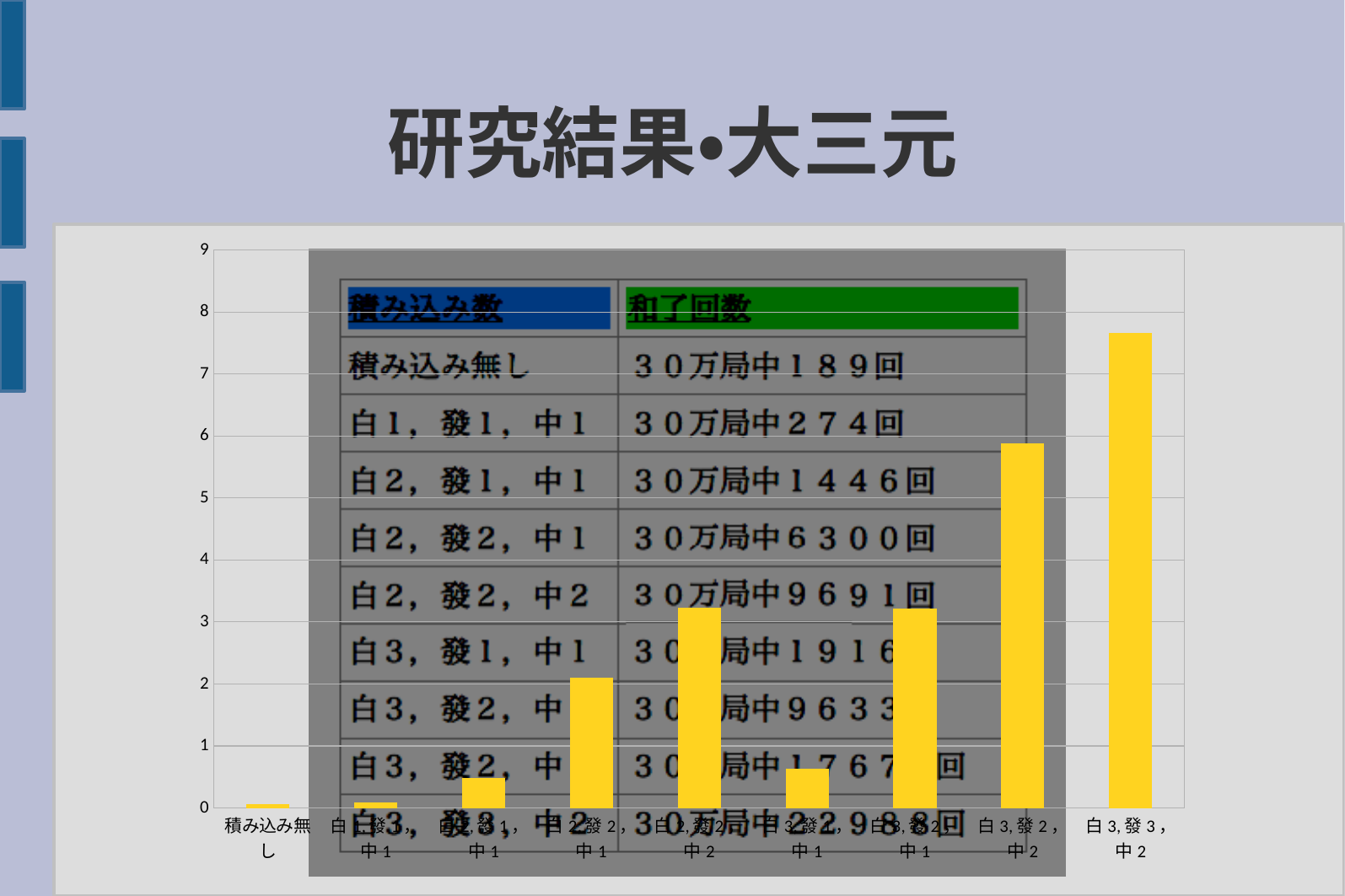
Which is larger, the value for 白3,發3,中2 or the value for 白3,發2,中2? 白3,發3,中2 Is the value for 白3,發3,中2 greater or less than 7? greater What kind of chart is shown on the slide? bar chart Is the value for 白3,發1,中1 greater or less than 1? less Is the value for 積み込み無し greater or less than 1? less How many categories are plotted along the x axis of the chart? 9 Which is larger, the value for 白2,發2,中2 or the value for 白3,發1,中1? 白2,發2,中2 What is the title of the slide containing the chart? 研究結果•大三元 Which category has the highest bar in the chart? 白3,發3,中2